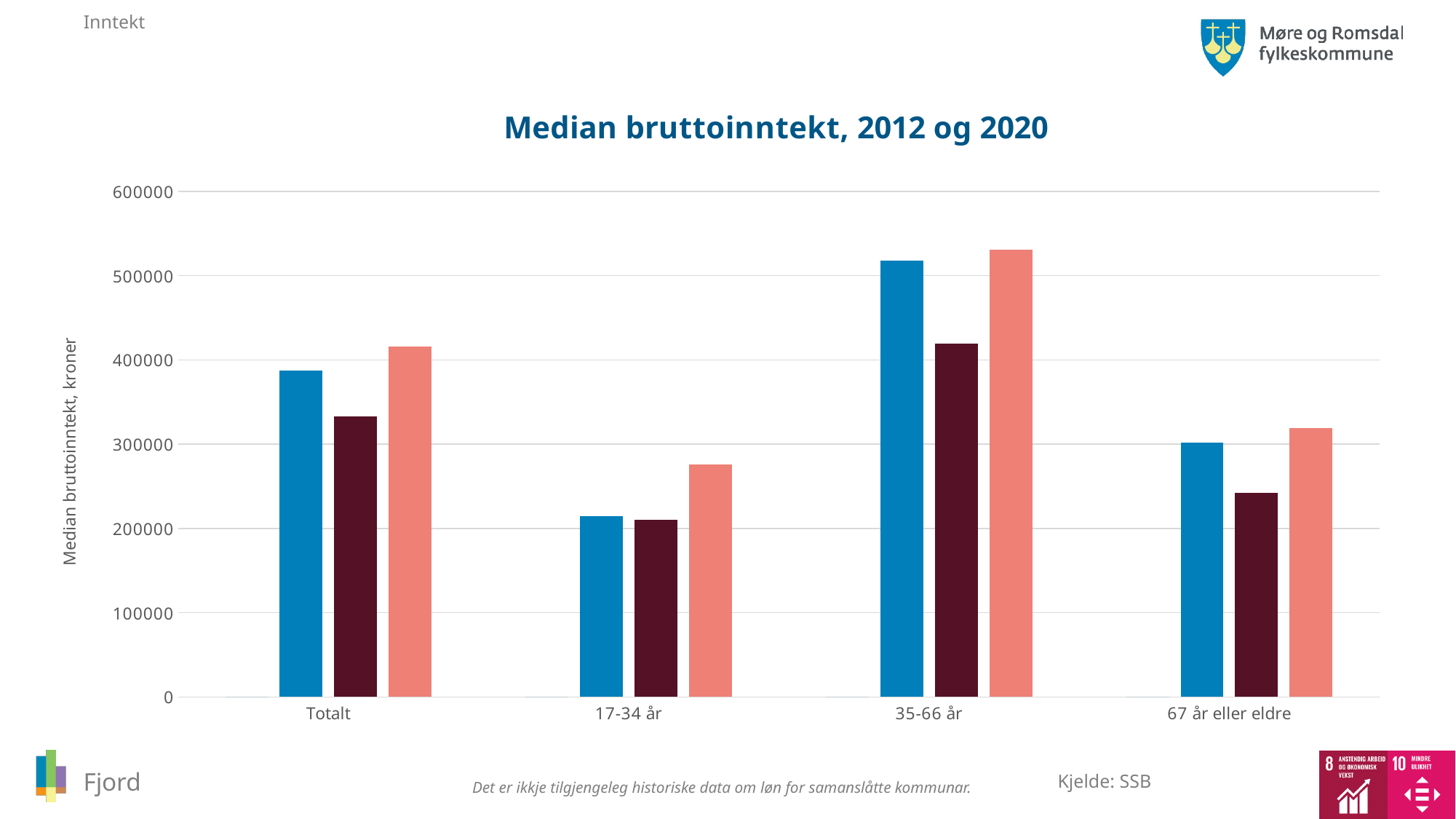
Which category has the lowest bars in the chart? 17-34 år How many bars are plotted for each category in the chart? 3 Is the dark red bar for 67 år eller eldre greater or less than 300000? less Is the tallest bar for 17-34 år greater or less than 300000? less Are the bars for 67 år eller eldre higher or lower than the bars for Totalt? lower Which category has the highest bars in the chart? 35-66 år Is the tallest bar for 35-66 år greater or less than 500000? greater What is the title of the chart? Median bruttoinntekt, 2012 og 2020 What kind of chart is shown on the slide? Bar chart What is the label on the vertical axis of the chart? Median bruttoinntekt, kroner How many age categories are shown on the x axis of the chart? 4